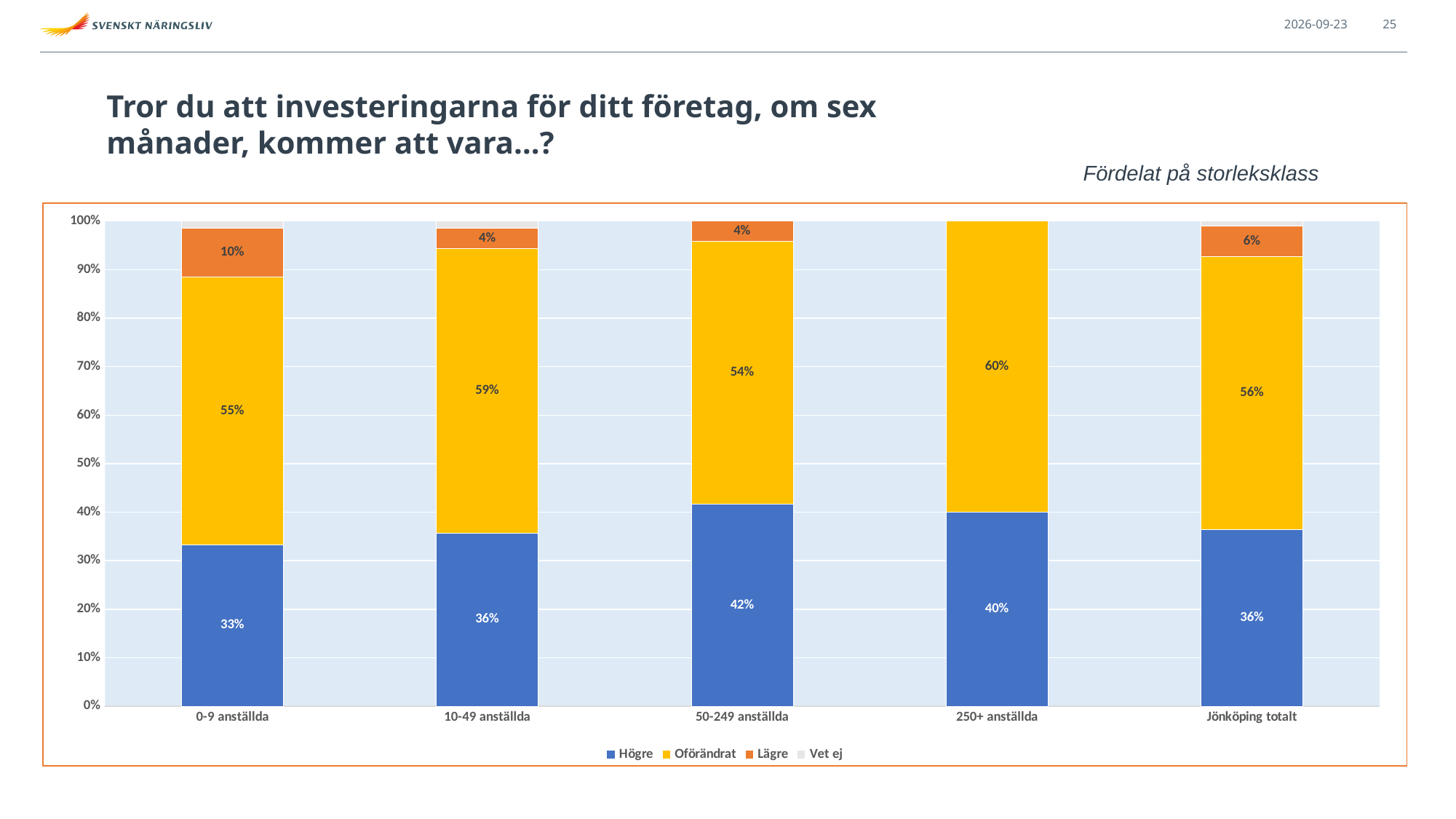
Which is larger, the Lägre value for 0-9 anställda or for Jönköping totalt? 0-9 anställda What is the Högre value for 50-249 anställda? 42% What is the Högre value for Jönköping totalt? 36% Which category has the highest Högre value? 50-249 anställda What is the difference between the Oförändrat values for 250+ anställda and 0-9 anställda? 5% Which series is shown in orange in the legend? Lägre What kind of chart is shown on the slide? Stacked bar chart Which category has the lowest Högre value? 0-9 anställda How many series does the legend list? 4 What is the Oförändrat value for 250+ anställda? 60% What is the Lägre value for 0-9 anställda? 10% How many categories are shown on the x axis? 5